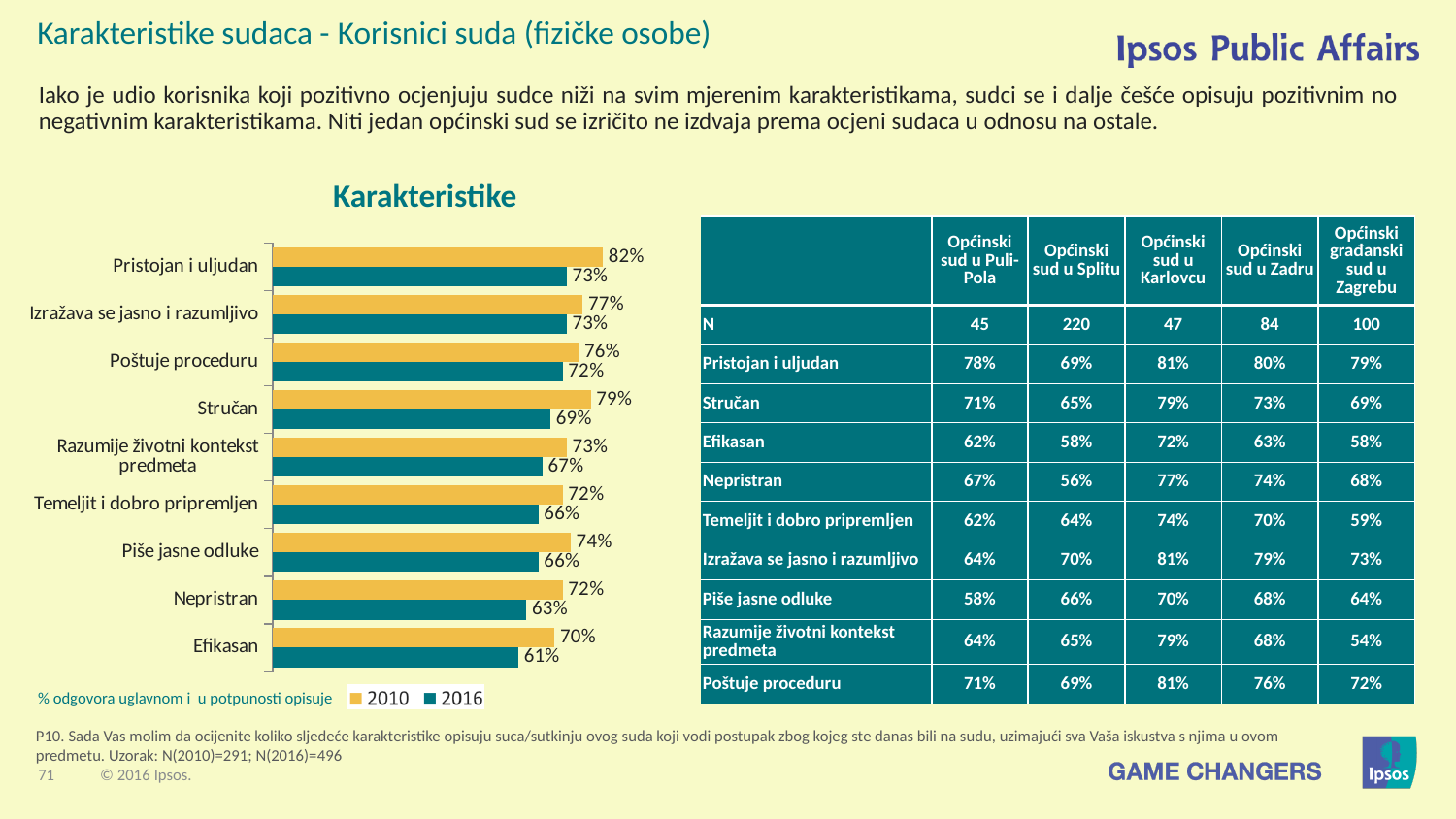
In the 'Karakteristike' chart, which is larger: the 2010 value for 'Piše jasne odluke' or the 2010 value for 'Nepristran'? Piše jasne odluke In the 'Karakteristike' chart, what is the 2016 value for 'Stručan'? 69% In the 'Karakteristike' chart, what is the 2010 value for 'Pristojan i uljudan'? 82% In the 'Karakteristike' chart, which colour represents the 2016 series? Teal In the 'Karakteristike' chart, which category has the lowest 2016 value? Efikasan In the 'Karakteristike' chart, what is the 2016 value for 'Nepristran'? 63% In the 'Karakteristike' chart, what is the difference between the 2010 and 2016 values for 'Efikasan'? 9 percentage points In the 'Karakteristike' chart, which category has the highest 2010 value? Pristojan i uljudan In the 'Karakteristike' chart, what is the difference between the 2010 and 2016 values for 'Stručan'? 10 percentage points What type of chart is the 'Karakteristike' chart? Bar chart How many categories are shown in the 'Karakteristike' chart? 9 How many series does the legend of the 'Karakteristike' chart list? 2